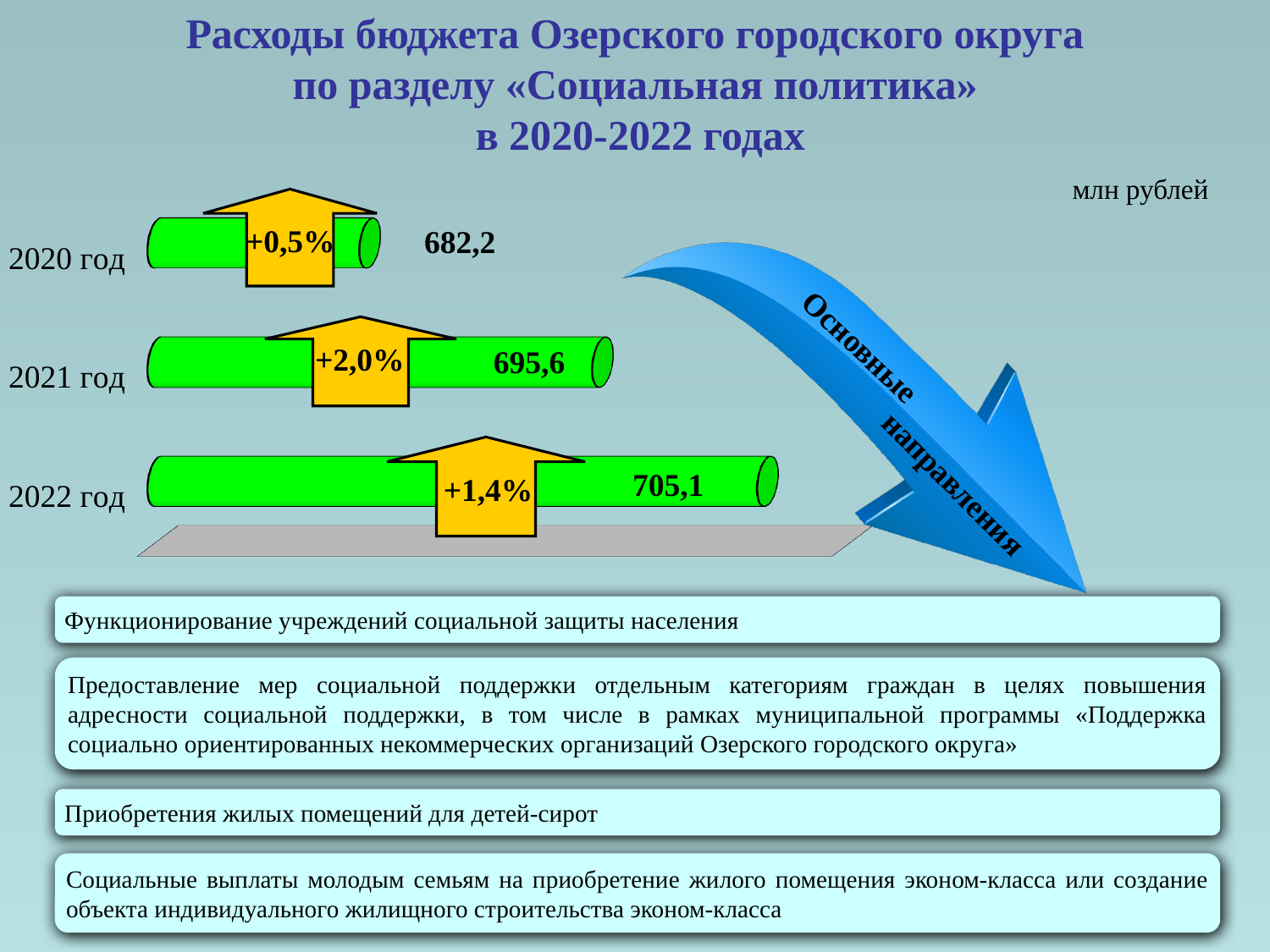
What percentage growth is shown on the arrow for 2022 год? +1,4% What percentage growth is shown on the arrow for 2021 год? +2,0% Which year has the lowest expenditure value? 2020 год What is the budget expenditure value shown for 2020 год? 682,2 What is the difference between the values for 2021 год and 2020 год? 13,4 Which year has the highest expenditure value? 2022 год How many years are shown in the chart? 3 Which is larger, the value for 2020 год or the value for 2021 год? 2021 год What is the budget expenditure value shown for 2022 год? 705,1 What is the budget expenditure value shown for 2021 год? 695,6 What unit of measurement is indicated for the chart values? млн рублей What is the difference between the values for 2022 год and 2021 год? 9,5